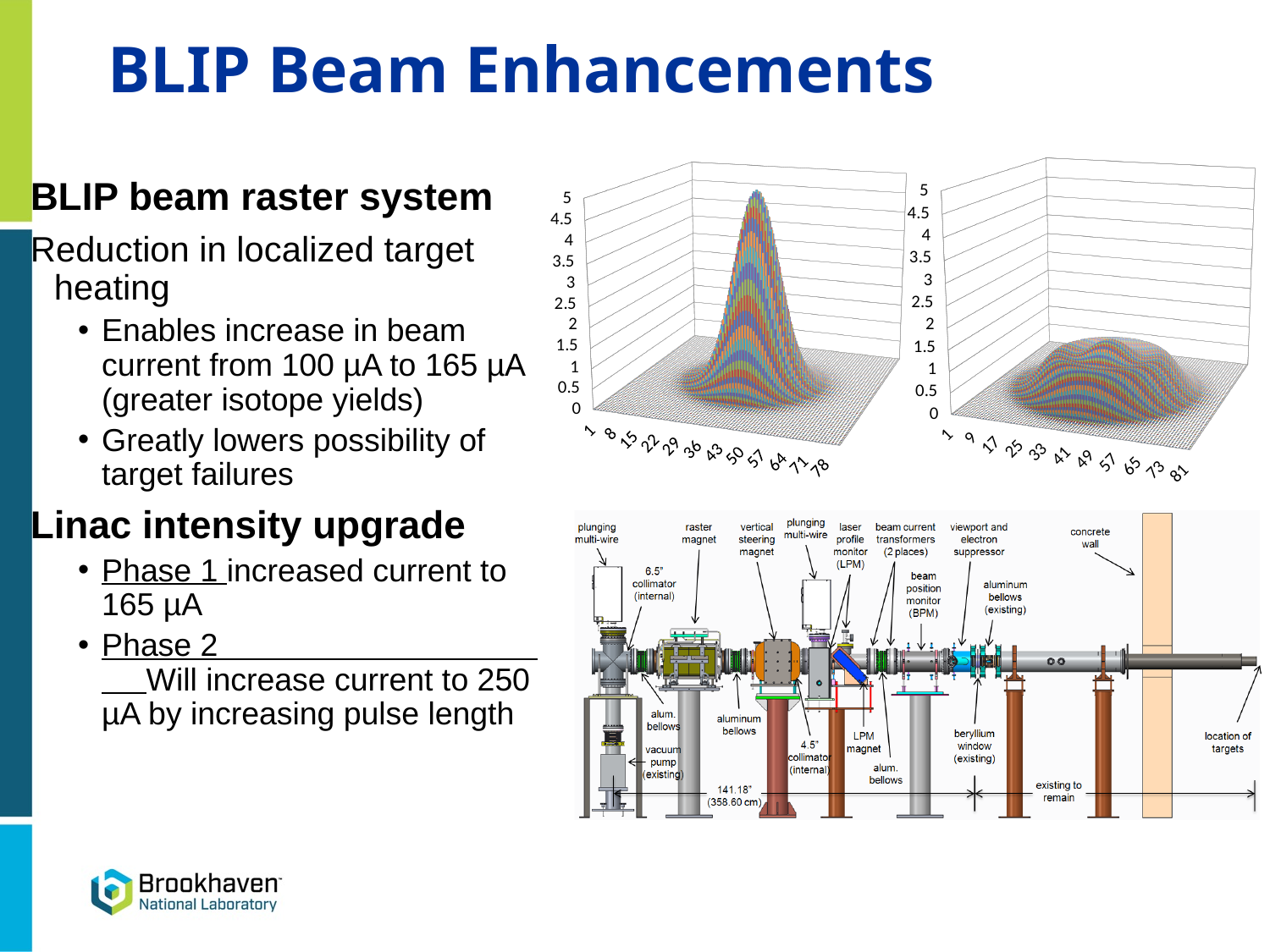
Which of the two surface charts has the higher peak, the left one or the right one? the left one What kind of chart is the left chart on the slide? 3D surface chart What kind of chart is the right chart on the slide? 3D surface chart On the left surface chart, is the peak value greater or less than 2? greater How many tick labels are shown along the horizontal axis of the right surface chart? 11 On the right surface chart, is the peak value greater or less than 3? less What is the last tick label on the horizontal axis of the right surface chart? 81 How many tick labels are shown along the horizontal axis of the left surface chart? 12 On the left surface chart, is the peak value greater or less than 3? greater What is the highest value shown on the vertical axis of the left surface chart? 5